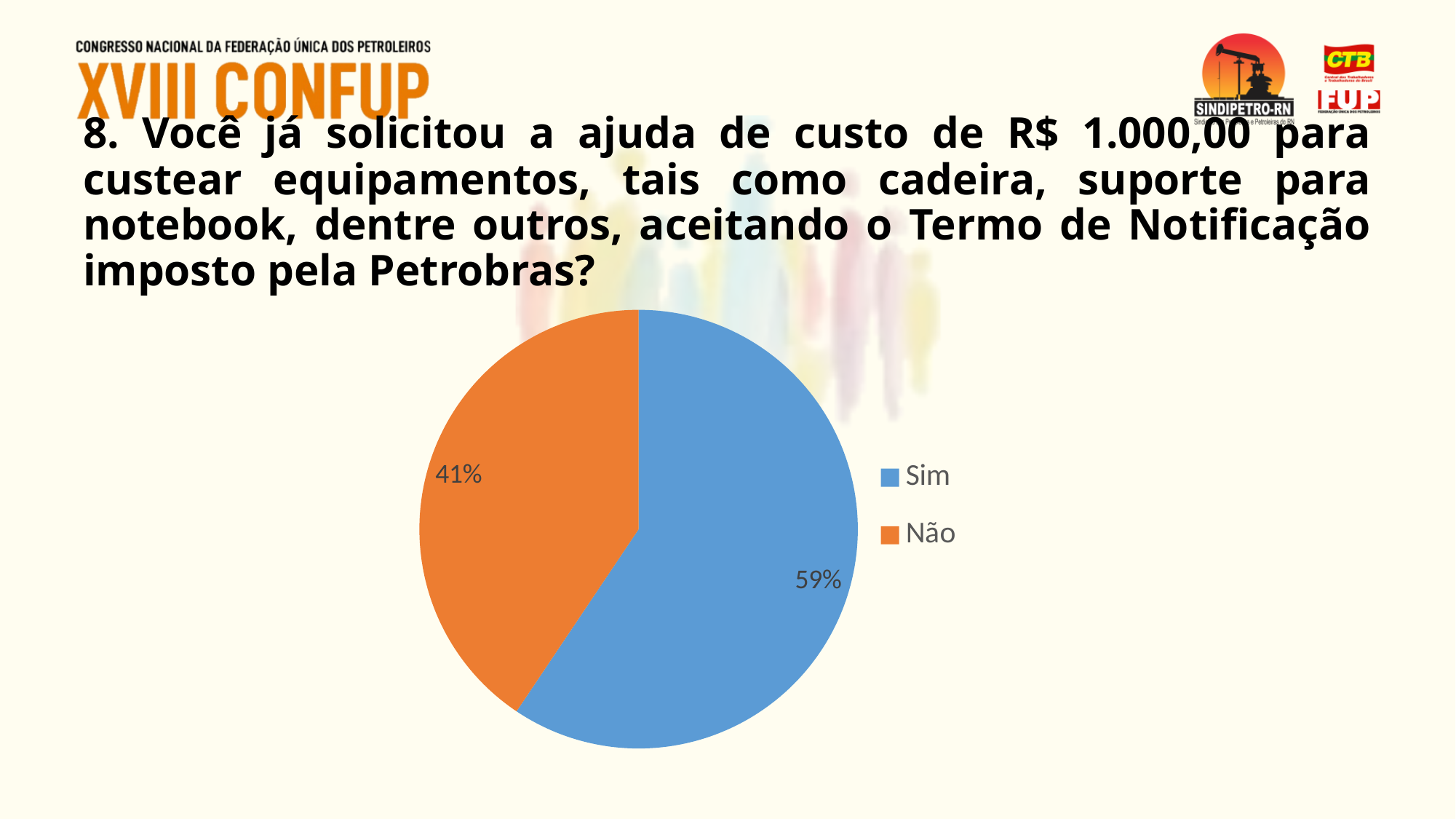
What colour is the "Sim" slice? blue How many entries does the legend list? 2 What share of the pie does the "Não" slice represent? 41% What is the difference in percentage points between the "Sim" and "Não" slices? 18 What percentage of respondents answered "Sim"? 59% What percentage of respondents answered "Não"? 41% What colour is the "Não" slice? orange How many slices does the pie chart have? 2 Which is larger, the share for "Sim" or the share for "Não"? Sim Which response has the largest share of the pie? Sim Which response has the smallest share of the pie? Não What kind of chart is shown on the slide? pie chart